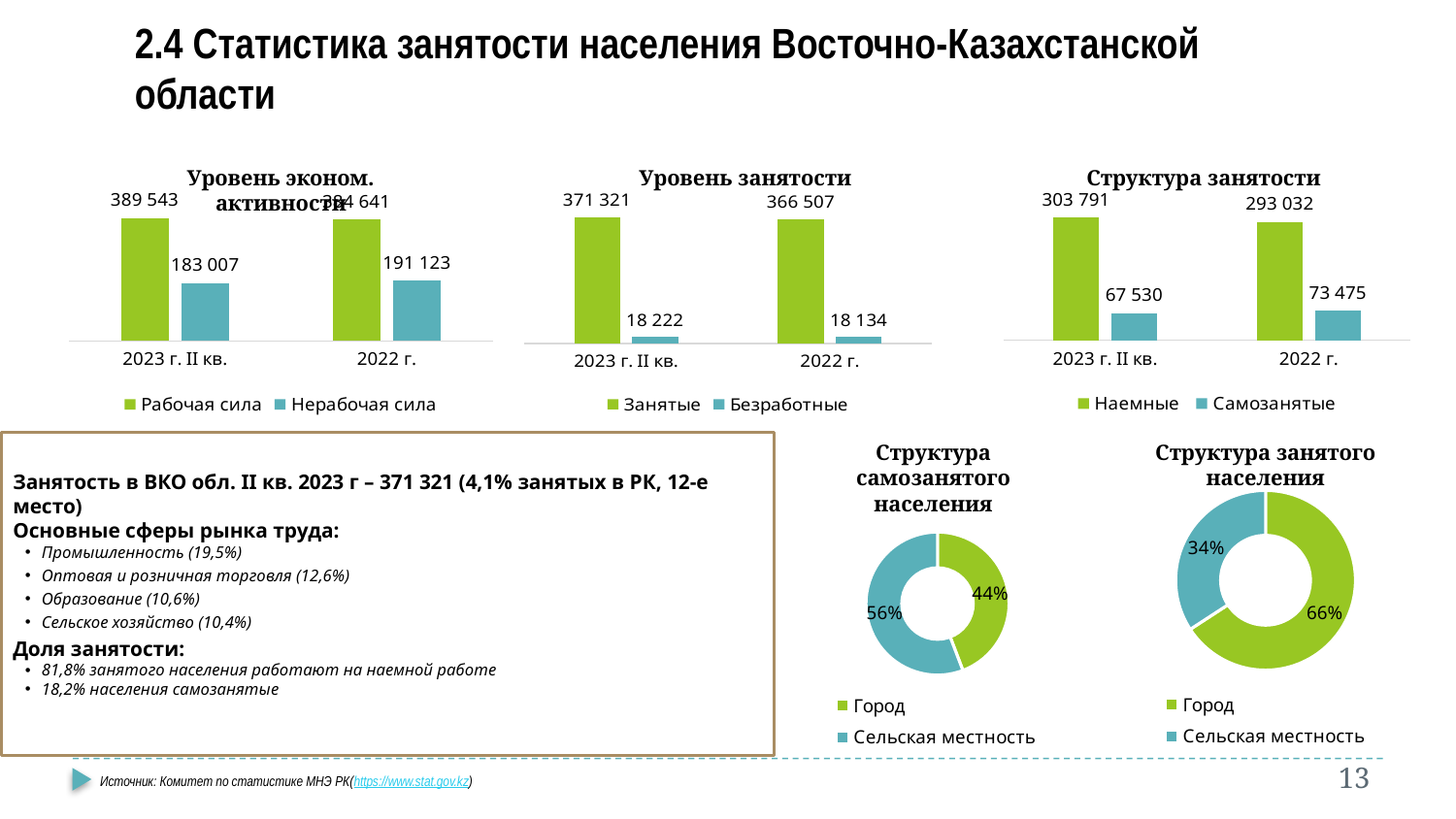
In the chart 'Структура занятости', how many series does the legend list? 2 In the chart 'Уровень эконом. активности', which category has the lowest value? Нерабочая сила, 2023 г. II кв. In the chart 'Уровень занятости', what is the value for Занятые in 2023 г. II кв.? 371 321 In the chart 'Уровень занятости', what is the value for Безработные in 2022 г.? 18 134 What type of chart is 'Уровень занятости'? Bar chart In the chart 'Уровень эконом. активности', what is the value for Нерабочая сила in 2022 г.? 191 123 In the chart 'Структура занятости', what is the difference between Наемные in 2023 г. II кв. and Наемные in 2022 г.? 10 759 In the chart 'Уровень занятости', which is larger: Занятые in 2023 г. II кв. or Занятые in 2022 г.? 2023 г. II кв. In the chart 'Структура самозанятого населения', what share does Сельская местность have? 56% In the chart 'Структура занятости', what is the value for Самозанятые in 2023 г. II кв.? 67 530 In the chart 'Структура занятого населения', which slice is larger: Город or Сельская местность? Город In the chart 'Структура занятого населения', what share does Город have? 66%